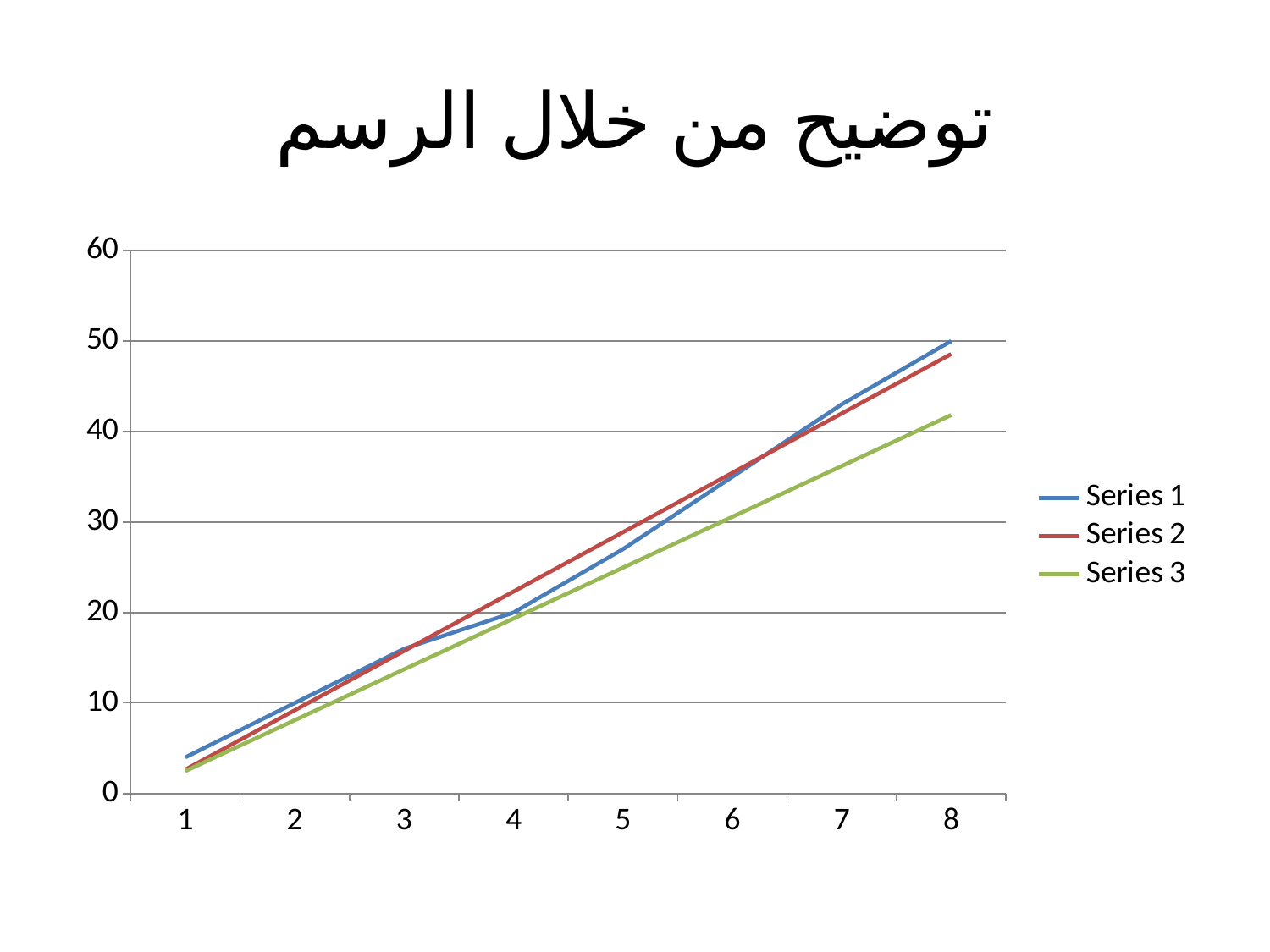
At x = 8, which is larger, Series 1 or Series 3? Series 1 Is the value for Series 1 at x = 1 greater or less than 10? less Is the value for Series 1 at x = 7 greater or less than 40? greater Which series has the lowest value at x = 8? Series 3 Is the value for Series 2 at x = 8 greater or less than 50? less What is the title of the slide? توضيح من خلال الرسم Do the values of Series 1 rise or fall as the x axis goes from 1 to 8? rise What kind of chart is shown on the slide? line chart Which series has the highest value at x = 8? Series 1 How many series does the legend list? 3 How many points are plotted along the x axis for each series? 8